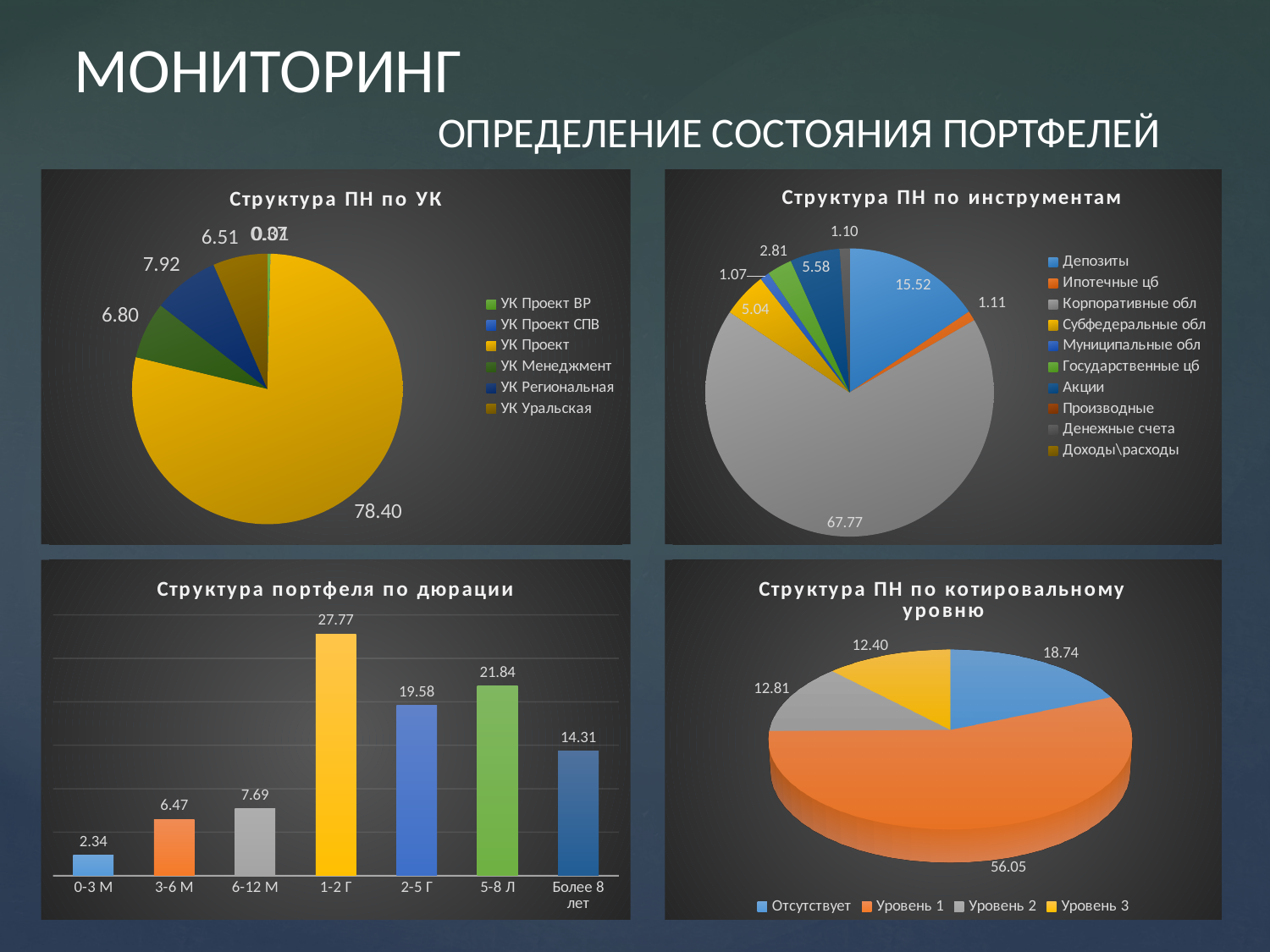
In the chart 'Структура портфеля по дюрации', which category has the lowest value? 0-3 М In the chart 'Структура ПН по инструментам', which is larger: 'Депозиты' or 'Акции'? Депозиты How many entries does the legend of the chart 'Структура ПН по котировальному уровню' list? 4 What type of chart is 'Структура портфеля по дюрации'? Bar chart How many categories are shown in the chart 'Структура портфеля по дюрации'? 7 In the chart 'Структура ПН по инструментам', what is the value shown for 'Корпоративные обл'? 67.77 In the chart 'Структура портфеля по дюрации', what is the value for the category '1-2 Г'? 27.77 In the chart 'Структура портфеля по дюрации', which category has the highest value? 1-2 Г How many entries does the legend of the chart 'Структура ПН по УК' list? 6 In the chart 'Структура ПН по котировальному уровню', what is the value shown for 'Уровень 1'? 56.05 In the chart 'Структура портфеля по дюрации', what is the difference between the values for '5-8 Л' and '2-5 Г'? 2.26 In the chart 'Структура ПН по УК', what is the value shown for 'УК Проект'? 78.40